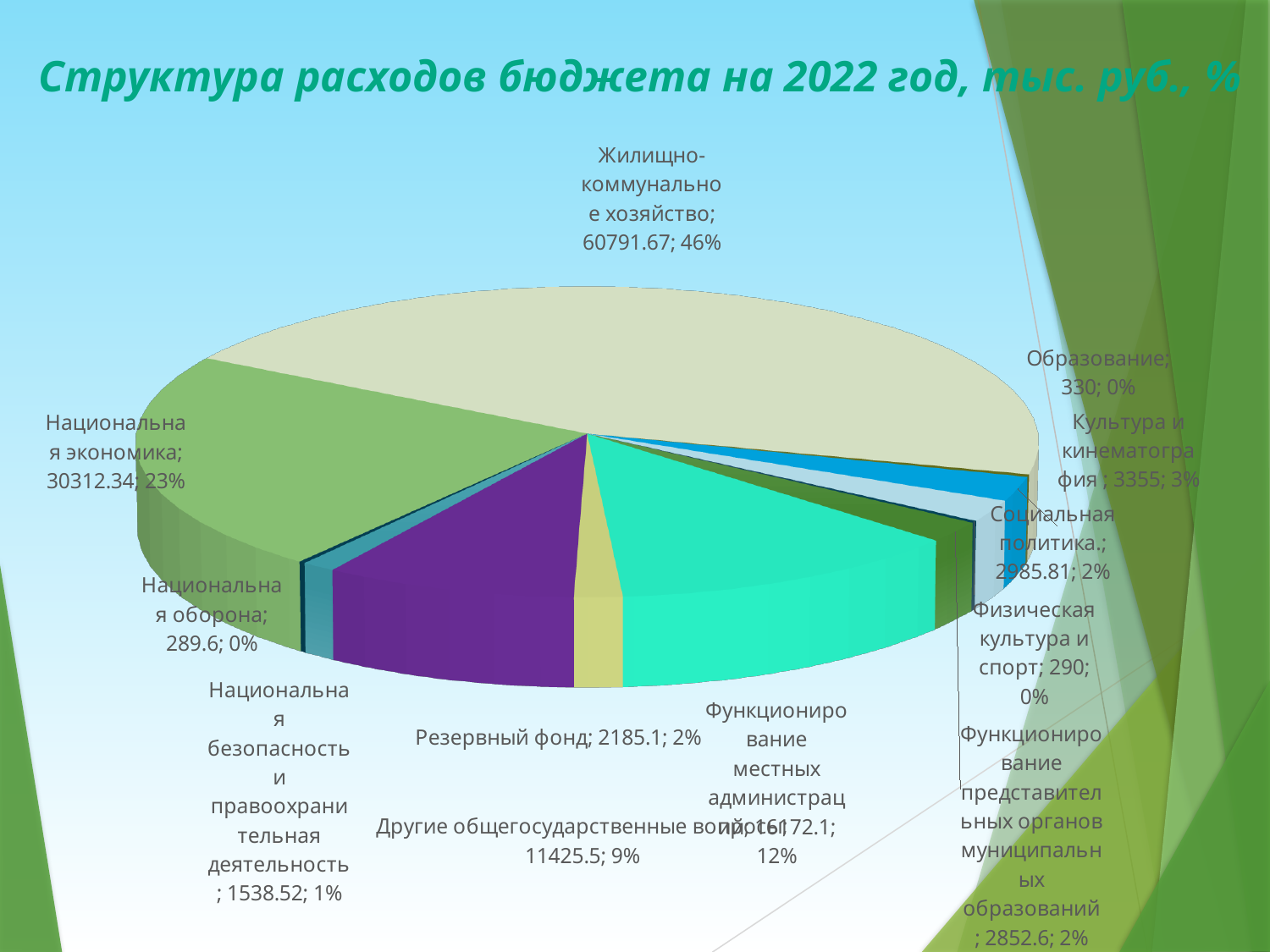
What kind of chart is shown on the slide? pie chart What is the value for Жилищно-коммунальное хозяйство? 60791.67 What is the value for Национальная экономика? 30312.34 What share of the pie does Жилищно-коммунальное хозяйство take? 46% Which category has the largest slice of the pie? Жилищно-коммунальное хозяйство What share of the pie does Другие общегосударственные вопросы take? 9% What is the value for Резервный фонд? 2185.1 What share of the pie does Национальная экономика take? 23% What is the title of the chart? Структура расходов бюджета на 2022 год, тыс. руб., % What is the value for Культура и кинематография? 3355 Which is larger, the value for Образование or the value for Национальная оборона? Образование What is the difference between the values for Жилищно-коммунальное хозяйство and Национальная экономика? 30479.33